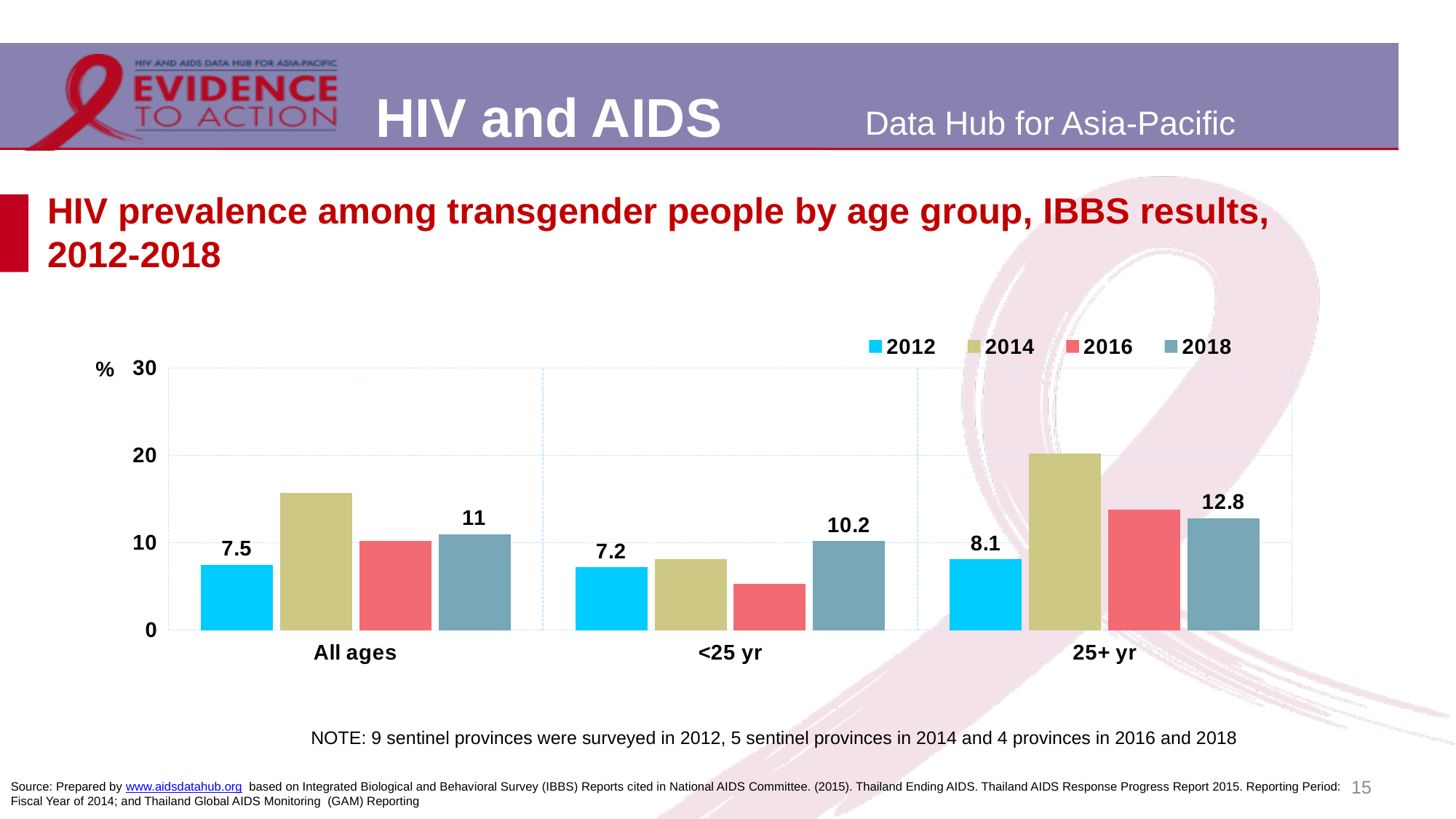
What is the HIV prevalence for 2018 in the <25 yr group? 10.2 What kind of chart is shown on the slide? bar chart What is the HIV prevalence for 2012 in the All ages group? 7.5 Is the 2014 value for the All ages group greater or less than 10? greater What is the difference between the 2018 and 2012 values for the 25+ yr group? 4.7 How many series does the legend list? 4 What is the HIV prevalence for 2012 in the 25+ yr group? 8.1 How many age groups are shown on the x axis? 3 Which age group has the highest 2018 value? 25+ yr Which is larger for the <25 yr group, the 2012 value or the 2018 value? 2018 What is the HIV prevalence for 2018 in the 25+ yr group? 12.8 Which age group has the lowest 2012 value? <25 yr